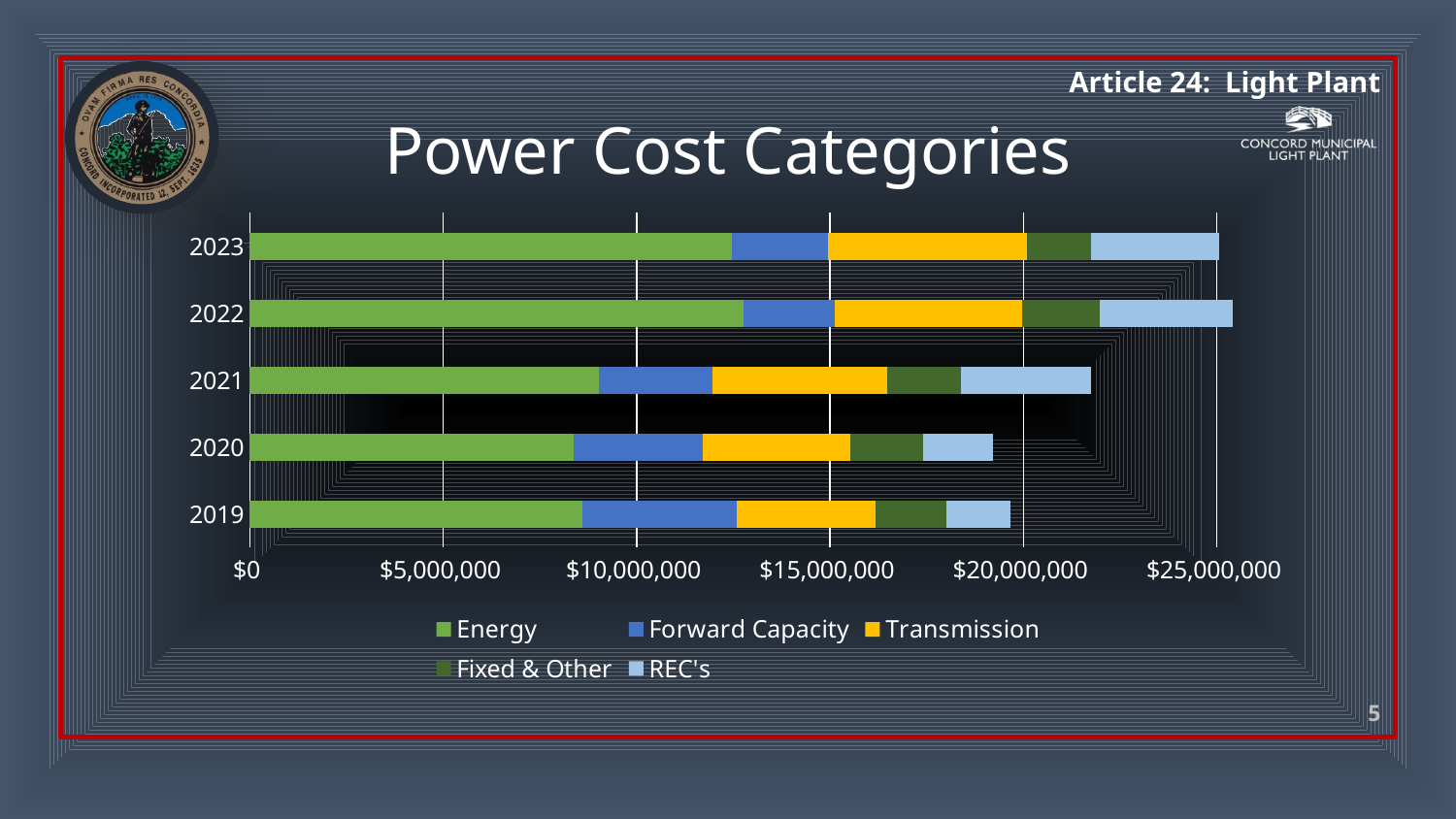
Is the total power cost for 2021 greater or less than $20,000,000? greater Is the Energy value for 2023 greater or less than $10,000,000? greater How many series does the legend list? 5 Is the Energy value for 2020 greater or less than $10,000,000? less Which year has the larger total power cost, 2023 or 2019? 2023 What is the title of the chart? Power Cost Categories Which year has the larger Energy value, 2022 or 2020? 2022 What type of chart is shown on the slide? Bar chart How many years are shown on the chart? 5 Which series is shown in yellow? Transmission